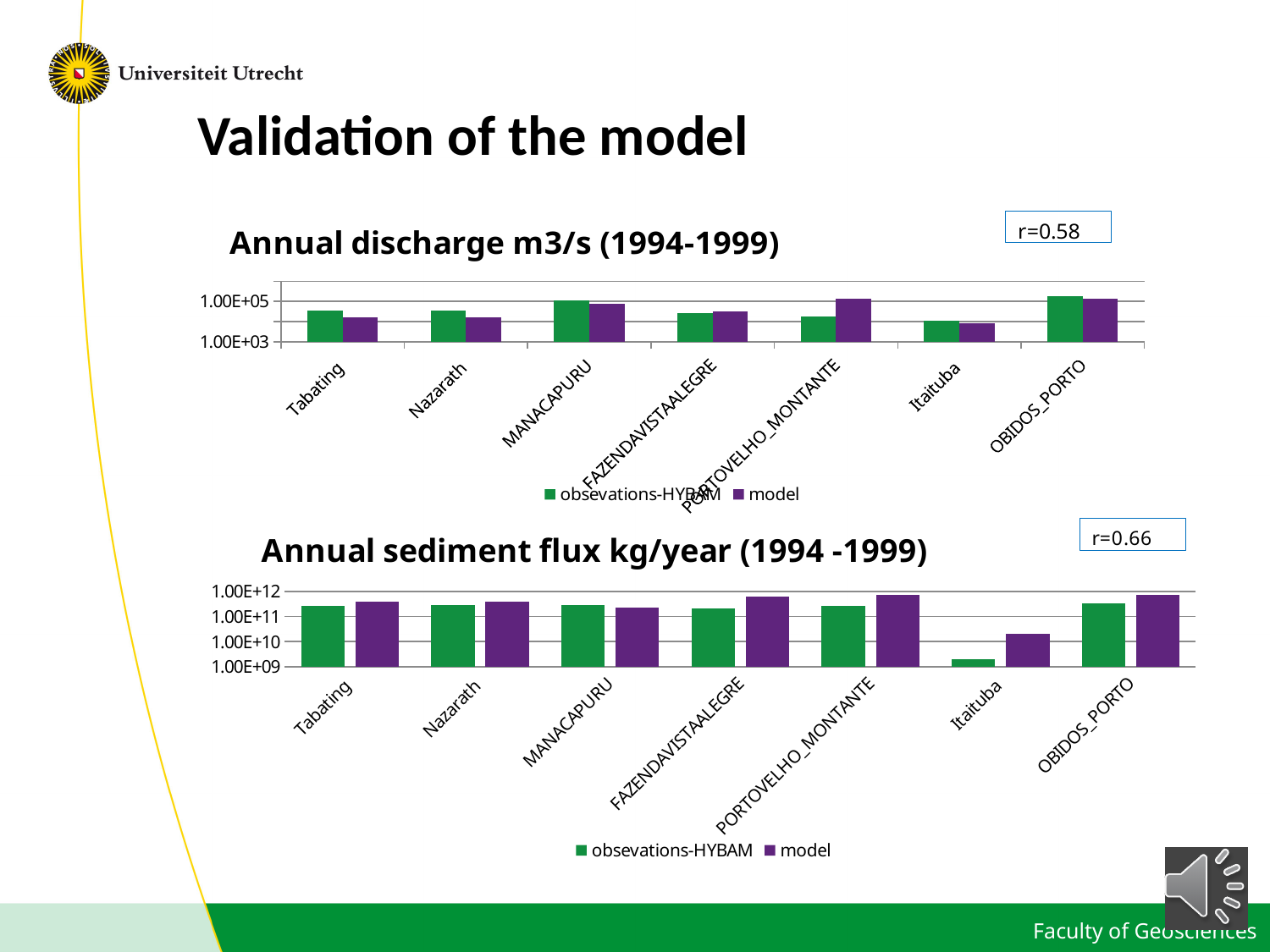
How many series does the legend of the 'Annual discharge m3/s (1994-1999)' chart list? 2 In the 'Annual sediment flux kg/year (1994 -1999)' chart, which station has the lowest obsevations-HYBAM value? Itaituba In the 'Annual sediment flux kg/year (1994 -1999)' chart, which is larger for Itaituba: the obsevations-HYBAM value or the model value? model How many stations are shown on the x axis of the 'Annual sediment flux kg/year (1994 -1999)' chart? 7 What correlation value (r) is shown next to the 'Annual sediment flux kg/year (1994 -1999)' chart? r=0.66 In the 'Annual sediment flux kg/year (1994 -1999)' chart, is the model value for Tabating greater or less than 1.00E+11? greater In the 'Annual sediment flux kg/year (1994 -1999)' chart, is the obsevations-HYBAM value for Itaituba greater or less than 1.00E+10? less In the 'Annual discharge m3/s (1994-1999)' chart, is the model value for Itaituba greater or less than 1.00E+05? less In the 'Annual discharge m3/s (1994-1999)' chart, which station has the highest obsevations-HYBAM value? OBIDOS_PORTO What type of chart is the 'Annual discharge m3/s (1994-1999)' chart? bar chart In the 'Annual discharge m3/s (1994-1999)' chart, which is larger for Tabating: the obsevations-HYBAM value or the model value? obsevations-HYBAM